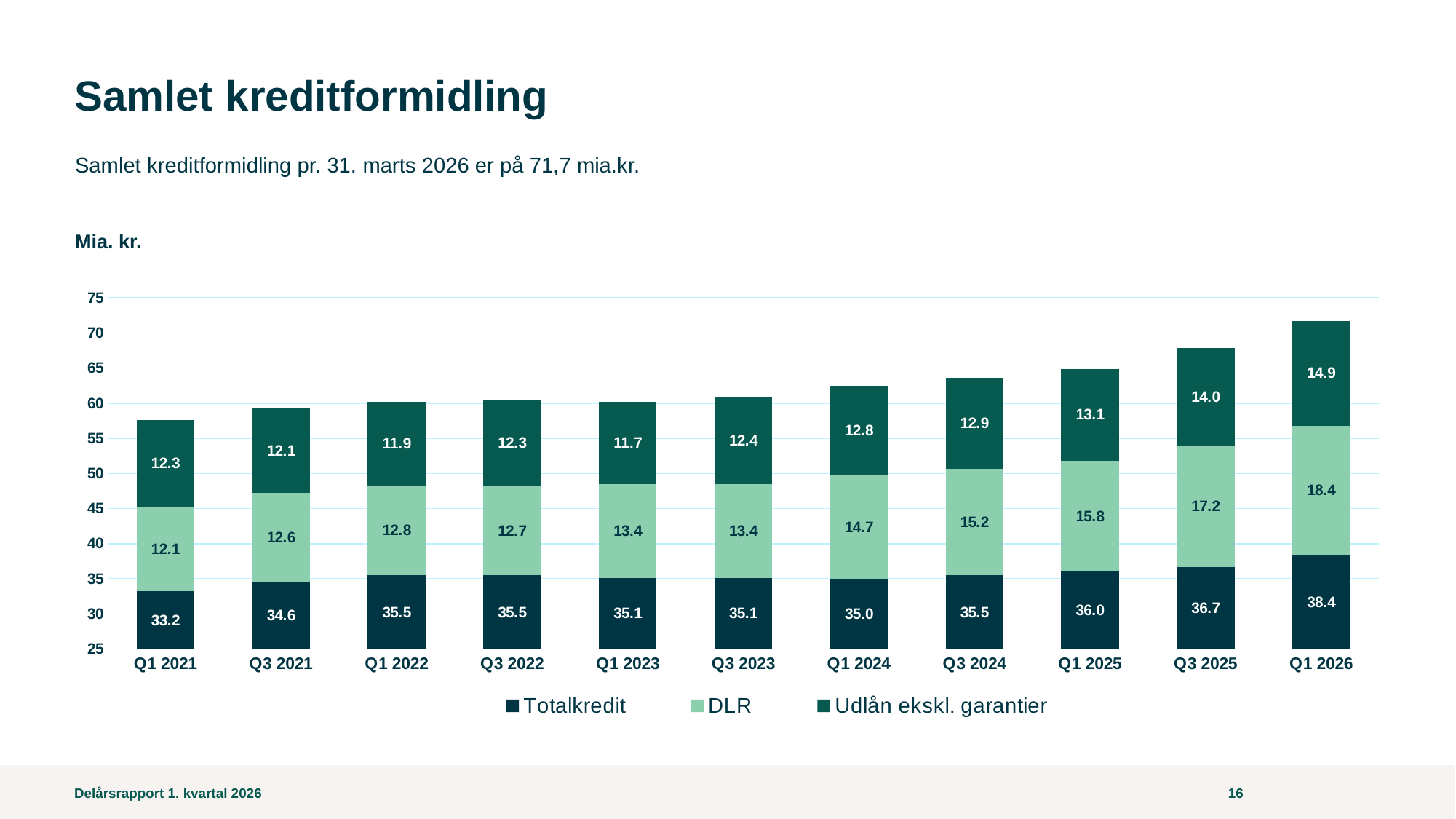
Does the DLR value rise or fall from Q1 2024 to Q1 2026? Rise Which is larger, the Udlån ekskl. garantier value in Q3 2025 or in Q1 2025? Q3 2025 What is the Totalkredit value for Q1 2026? 38.4 How many series does the legend list? 3 How many quarters are shown on the x axis? 11 What is the DLR value for Q3 2024? 15.2 What is the difference between the DLR value in Q1 2026 and in Q1 2021? 6.3 What is the total of the stacked bar for Q1 2026? 71.7 In which quarter is the Totalkredit value lowest? Q1 2021 What is the value of Udlån ekskl. garantier for Q1 2023? 11.7 In which quarter is the DLR value highest? Q1 2026 What type of chart is shown on the slide? Stacked bar chart